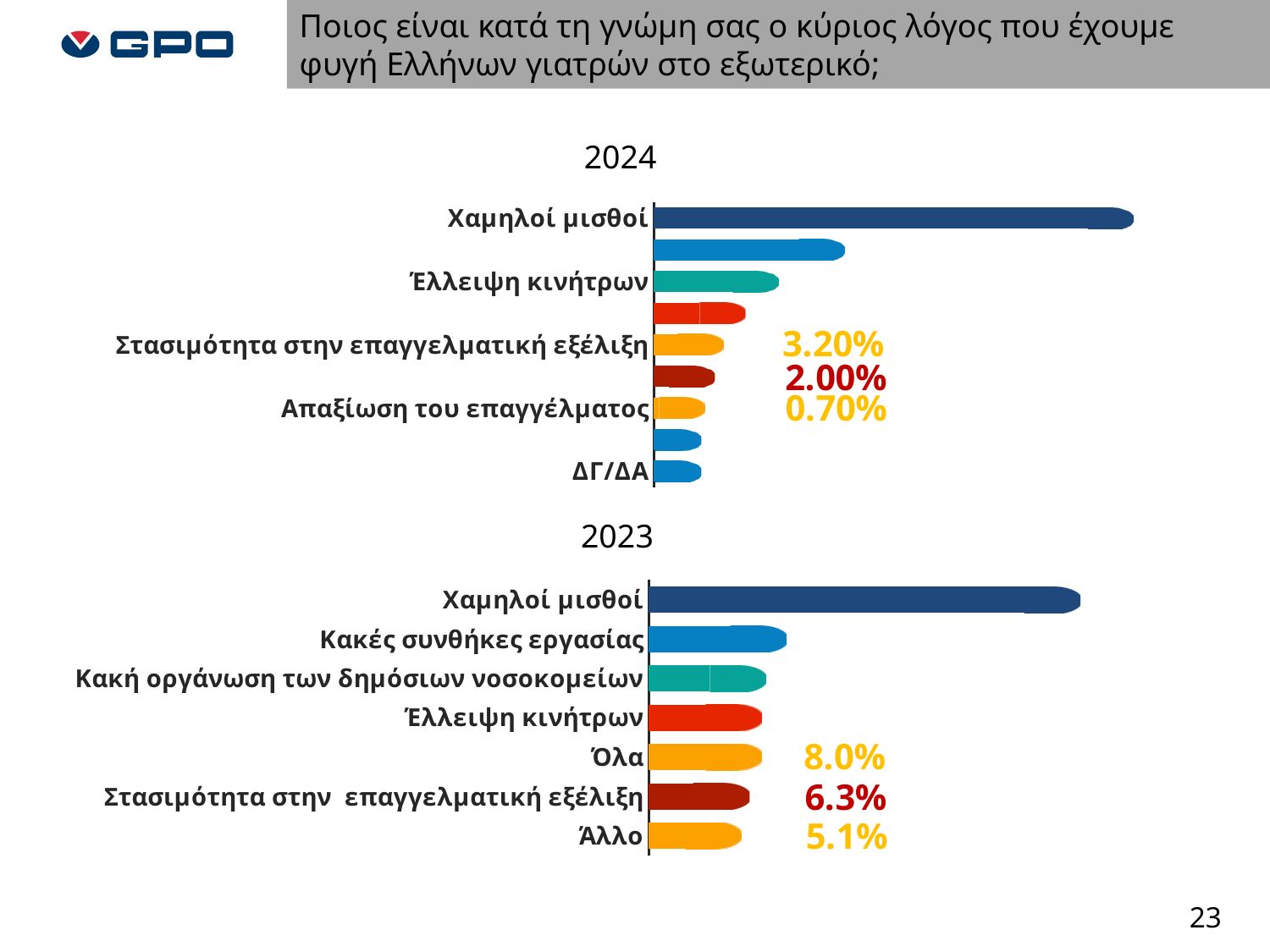
What is the title of the lower chart on the slide? 2023 In the 2023 chart, what value is shown for Στασιμότητα στην επαγγελματική εξέλιξη? 6.3% How many charts are on the slide? 2 In the 2023 chart, which category has the longest bar? Χαμηλοί μισθοί What kind of chart is the 2024 chart? bar chart In the 2023 chart, what value is shown for Όλα? 8.0% In the 2023 chart, which is larger: Κακές συνθήκες εργασίας or Άλλο? Κακές συνθήκες εργασίας In the 2023 chart, what value is shown for Άλλο? 5.1% How many bars are plotted in the 2023 chart? 7 In the 2023 chart, which is larger: Χαμηλοί μισθοί or Κακές συνθήκες εργασίας? Χαμηλοί μισθοί In the 2024 chart, which is larger: Χαμηλοί μισθοί or Έλλειψη κινήτρων? Χαμηλοί μισθοί In the 2024 chart, which category has the longest bar? Χαμηλοί μισθοί